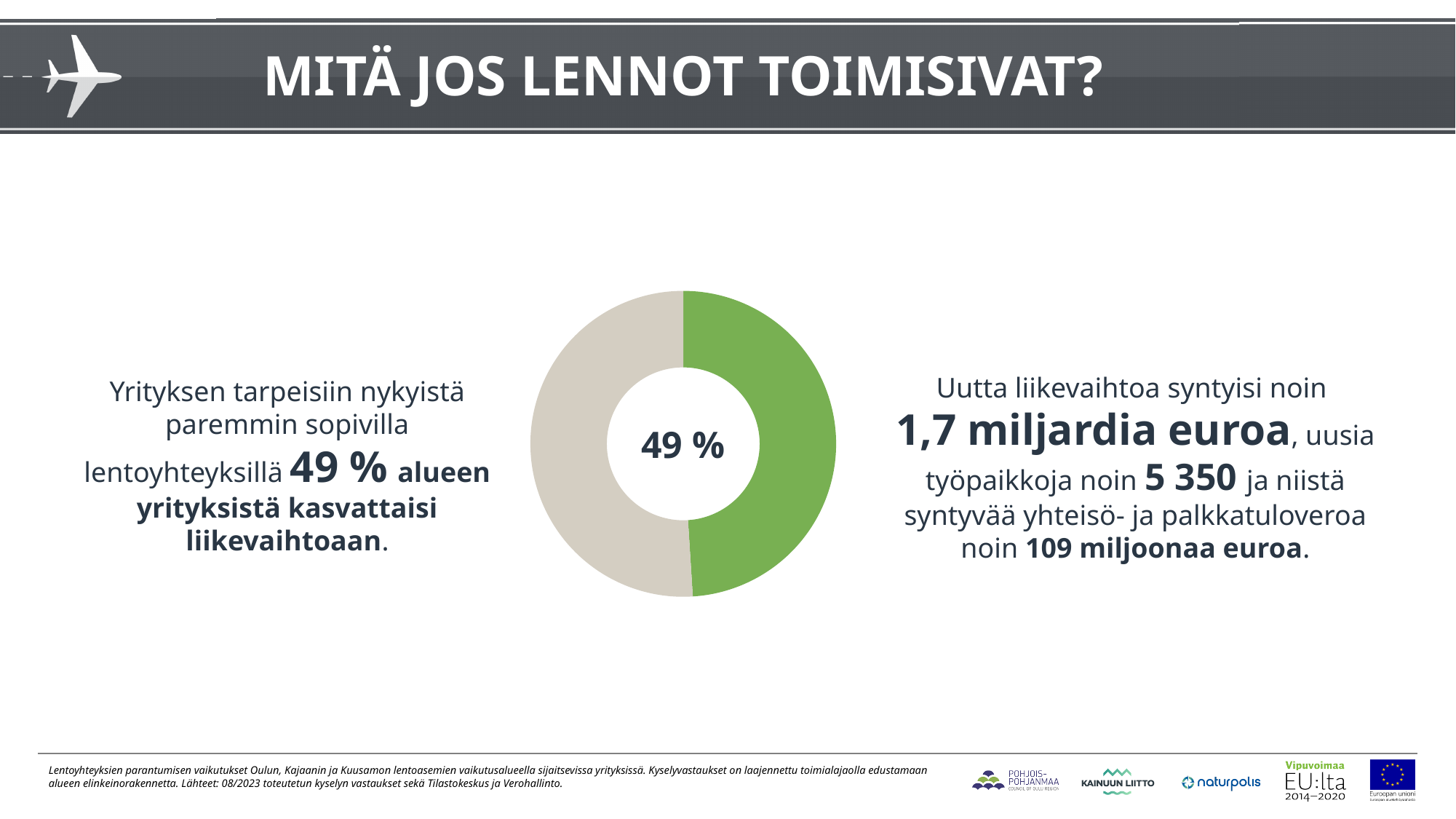
Is the value shown for the green slice of the donut chart greater or less than 50 %? less What colour is the slice of the donut chart that represents 49 %? Green What kind of chart is shown in the centre of the slide? Pie chart (donut) What value is printed in the centre of the donut chart? 49 % What colour is the remaining slice of the donut chart that is not green? Grey What share of the donut chart does the green slice represent? 49 % How many slices does the donut chart have? 2